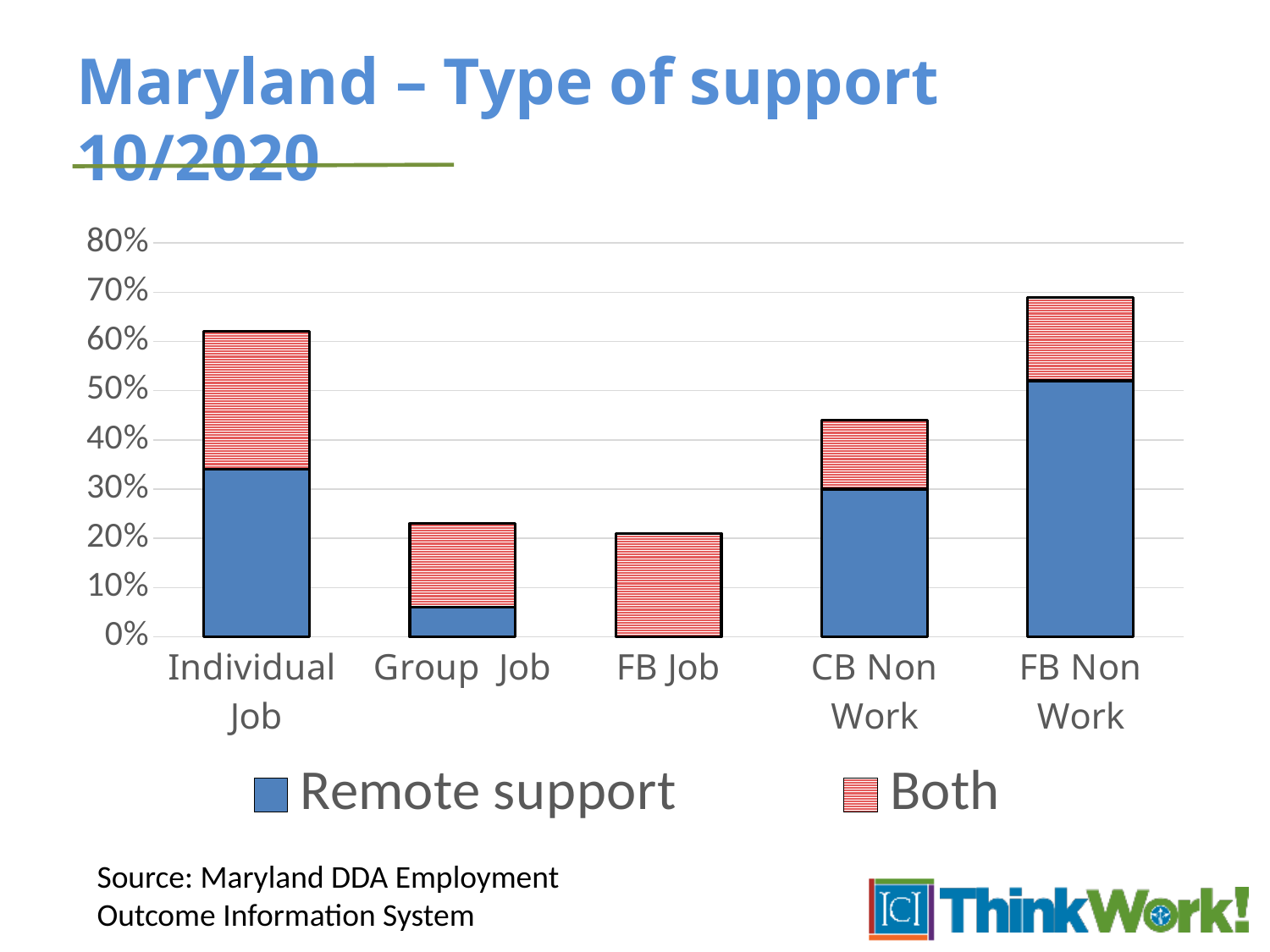
Which has a taller stacked bar overall, Individual Job or CB Non Work? Individual Job Is the Remote support value for FB Non Work greater or less than 40%? greater What is the title of the chart on the slide? Maryland – Type of support 10/2020 Which category has the smallest Remote support segment? FB Job Is the total stacked value for CB Non Work greater or less than 50%? less Is the total stacked value for Individual Job greater or less than 50%? greater Which category has the tallest stacked bar overall? FB Non Work Which category has the largest Remote support segment? FB Non Work How many series does the legend list? 2 What kind of chart is shown on the slide? stacked bar chart How many categories are shown on the x axis? 5